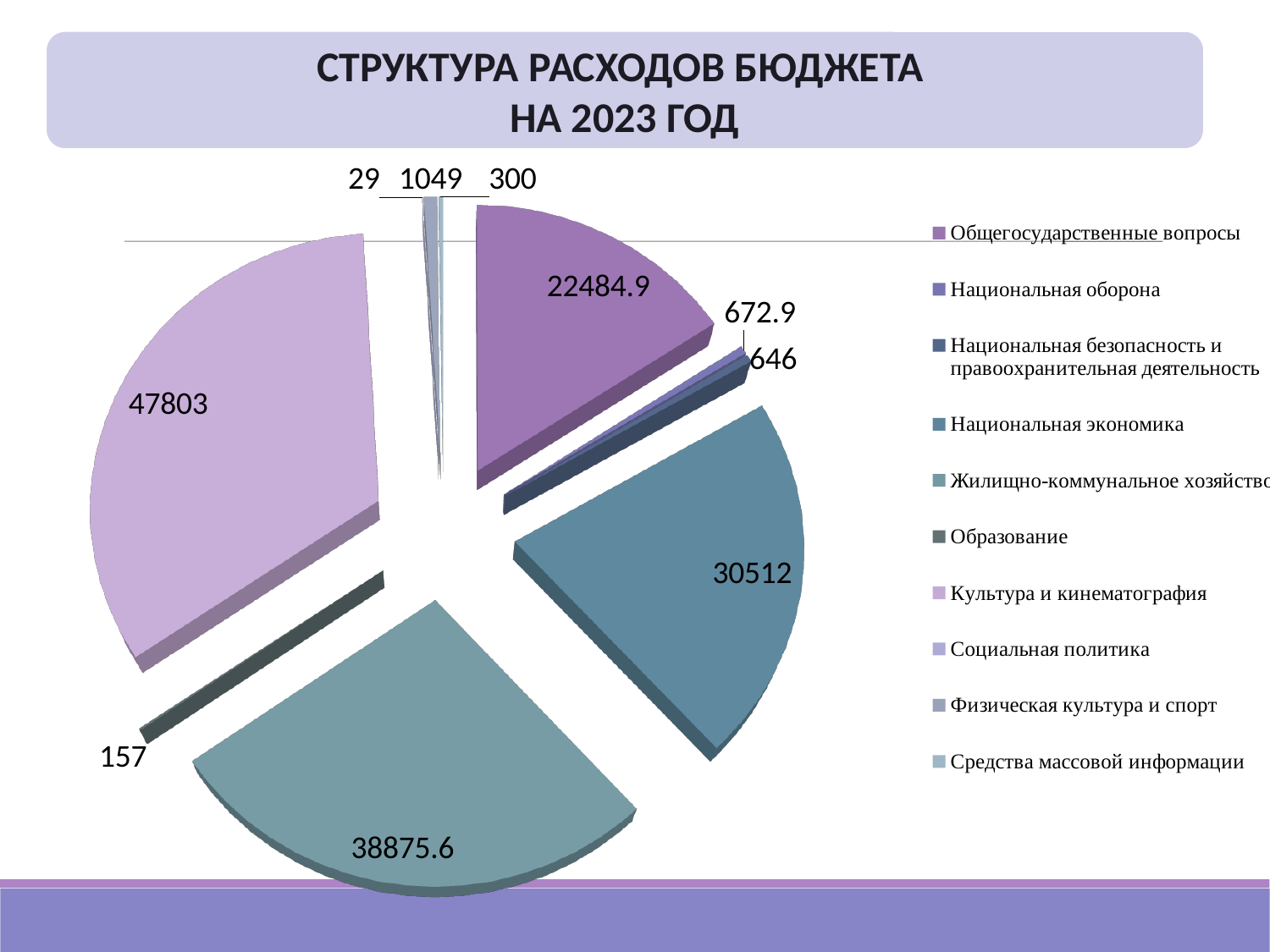
What is the value for Общегосударственные вопросы? 22484.9 How many categories does the legend list? 10 What kind of chart is shown on the slide? pie chart What is the value for Национальная оборона? 672.9 What is the smallest value labelled on the pie chart? 29 What is the value for Национальная экономика? 30512 What is the difference between the values for Культура и кинематография and Жилищно-коммунальное хозяйство? 8927.4 Which is larger: the value for Национальная экономика or the value for Общегосударственные вопросы? Национальная экономика Which category has the largest slice of the pie? Культура и кинематография What is the value for Жилищно-коммунальное хозяйство? 38875.6 What is the value for Культура и кинематография? 47803 What is the value for Образование? 157